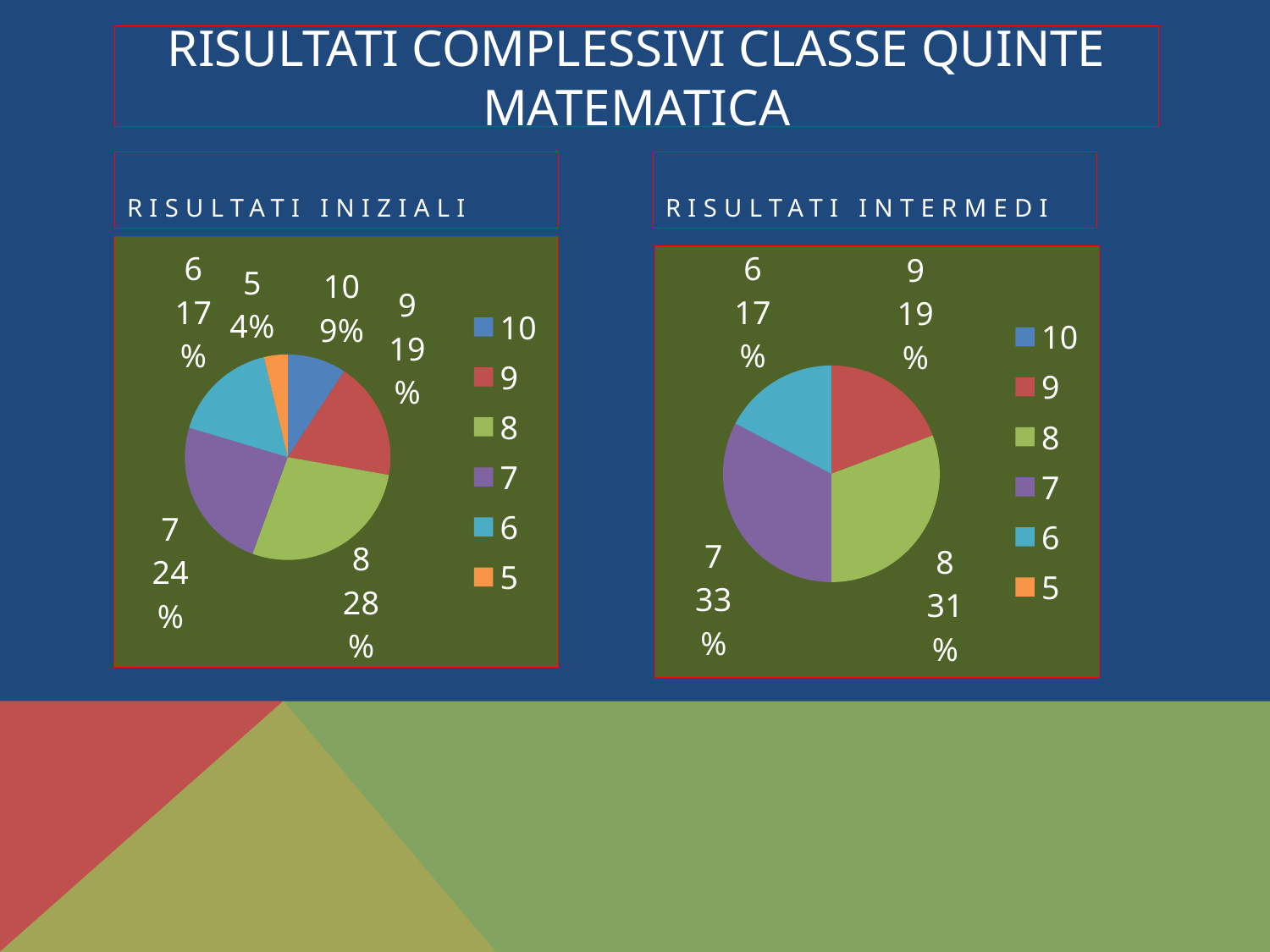
In the RISULTATI INIZIALI chart, what is the difference in percentage points between grade 8 and grade 7? 4 In the RISULTATI INIZIALI chart, what share of the pie does grade 8 have? 28% In the RISULTATI INIZIALI chart, what percentage is shown for grade 5? 4% How many entries does the legend of the RISULTATI INTERMEDI chart list? 6 In the RISULTATI INTERMEDI chart, what percentage is shown for grade 7? 33% In the RISULTATI INIZIALI chart, which grade has the largest slice? 8 In the RISULTATI INTERMEDI chart, which grade has the largest slice? 7 What is the title of the chart on the right side of the slide? RISULTATI INTERMEDI In the RISULTATI INIZIALI chart, which grade has the smallest slice? 5 In the RISULTATI INTERMEDI chart, which is larger, the slice for grade 9 or the slice for grade 6? 9 In the RISULTATI INTERMEDI chart, what share of the pie does grade 8 have? 31% What kind of chart is the RISULTATI INIZIALI chart? pie chart